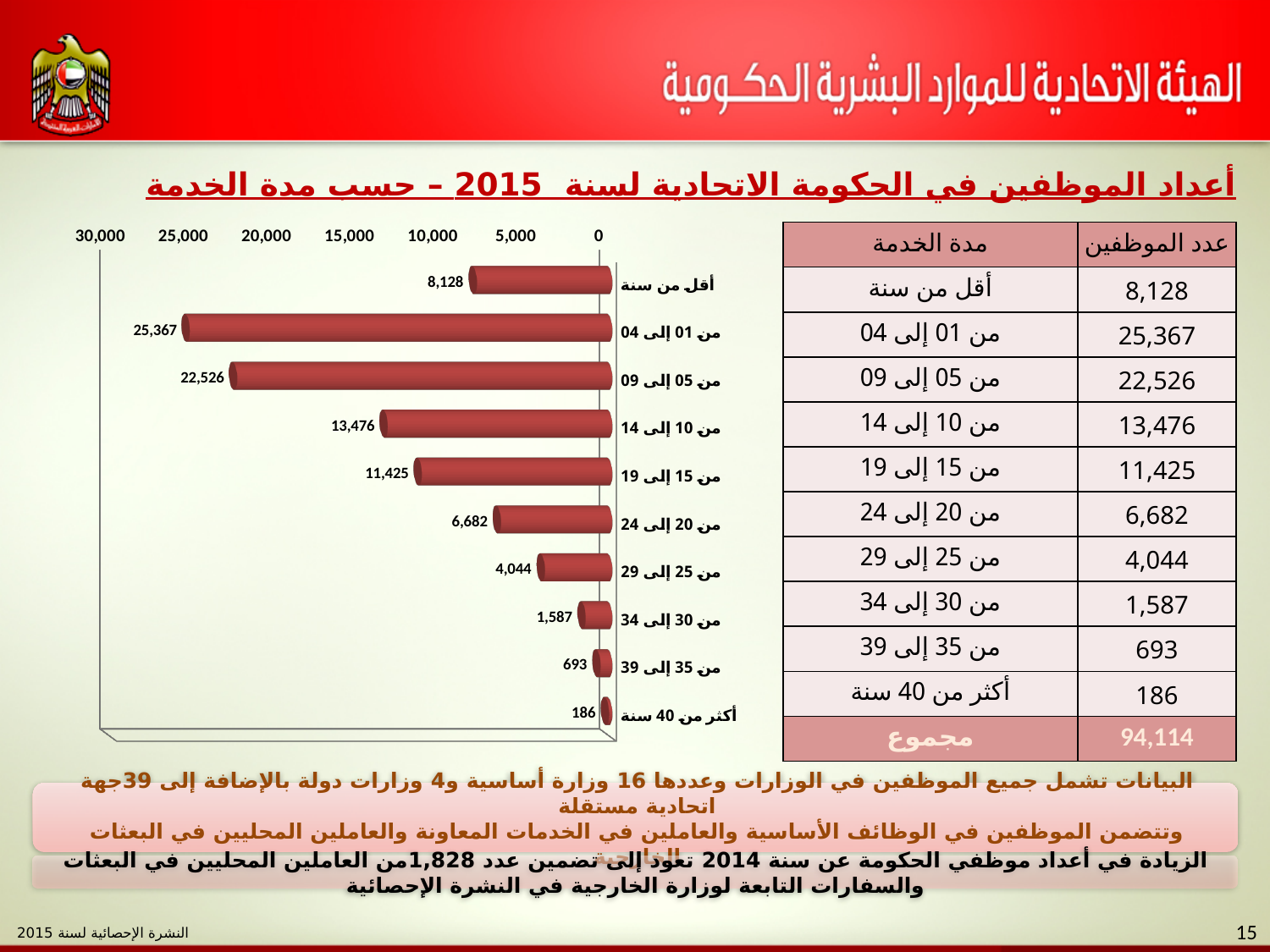
Which service-duration category has the lowest number of employees? أكثر من 40 سنة What is the value shown for the category أكثر من 40 سنة? 186 How many service-duration categories are plotted in the chart? 10 What is the value shown for the category من 01 إلى 04? 25,367 Which service-duration category has the highest number of employees? من 01 إلى 04 What is the difference between the values for من 01 إلى 04 and من 05 إلى 09? 2,841 What type of chart is shown on the slide? bar chart What is the number of employees with less than one year of service (أقل من سنة)? 8,128 Which is larger, the value for من 10 إلى 14 or the value for من 15 إلى 19? من 10 إلى 14 What is the total number of employees shown in the table (مجموع)? 94,114 Is the value for من 20 إلى 24 greater or less than 10,000? less What is the value shown for the category من 15 إلى 19? 11,425